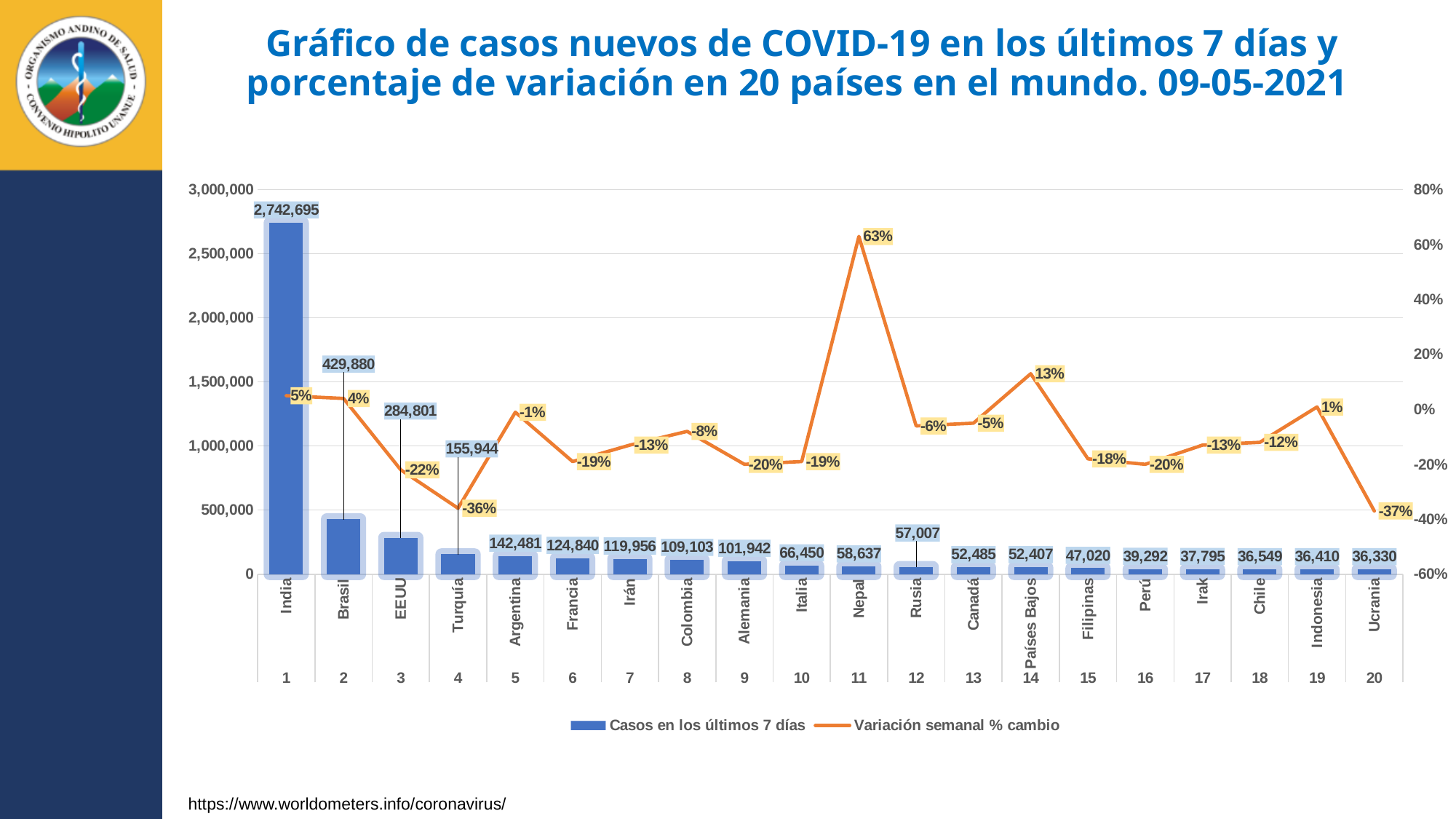
What is the value of 'Casos en los últimos 7 días' for Brasil? 429,880 How many series does the legend list? 2 Which has more cases in the last 7 days, Francia or Irán? Francia What is the difference in cases in the last 7 days between Brasil and EEUU? 145,079 How many countries are shown on the chart? 20 What is the 'Variación semanal % cambio' value for Nepal? 63% Which country has the lowest 'Variación semanal % cambio' value? Ucrania What kind of chart is used to show 'Casos en los últimos 7 días'? Bar chart What is the 'Variación semanal % cambio' value for Turquía? -36% Which country has the highest number of cases in the last 7 days? India What colour is the line for 'Variación semanal % cambio'? Orange Do the values for 'Casos en los últimos 7 días' rise or fall from India to Ucrania along the x axis? Fall